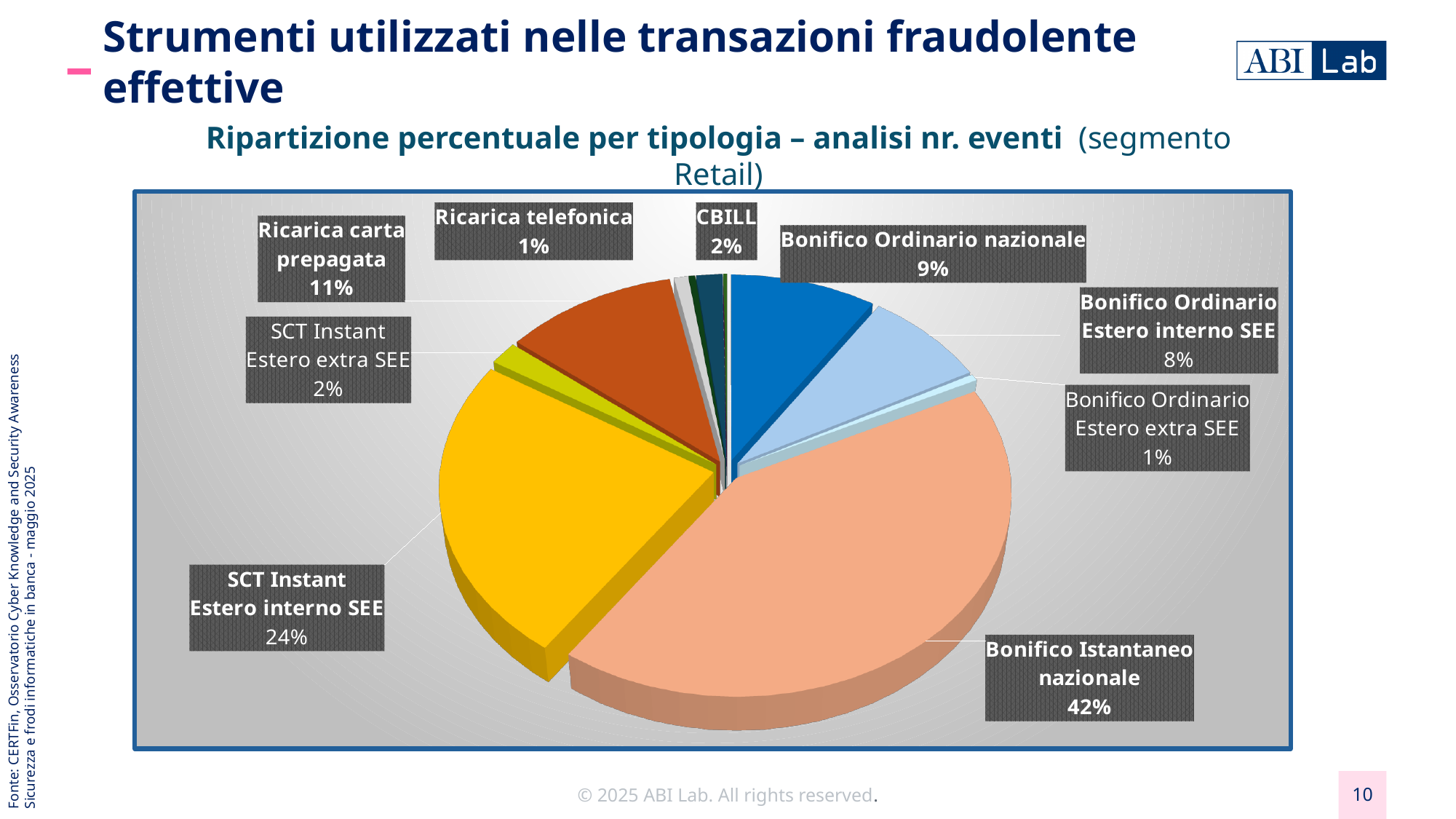
What percentage is shown for Bonifico Ordinario nazionale? 9% What is the difference in percentage points between Bonifico Istantaneo nazionale and SCT Instant Estero interno SEE? 18 Which segment does the chart title say the analysis refers to? Retail Which is larger, Bonifico Ordinario Estero interno SEE or Ricarica carta prepagata? Ricarica carta prepagata What is the difference in percentage points between Ricarica carta prepagata and Bonifico Ordinario nazionale? 2 What percentage is shown for SCT Instant Estero interno SEE? 24% Which category has the largest slice of the pie? Bonifico Istantaneo nazionale What share of the pie does Bonifico Istantaneo nazionale represent? 42% What is the value for Ricarica carta prepagata? 11% What type of chart is shown on the slide? Pie chart What is the value for CBILL? 2%